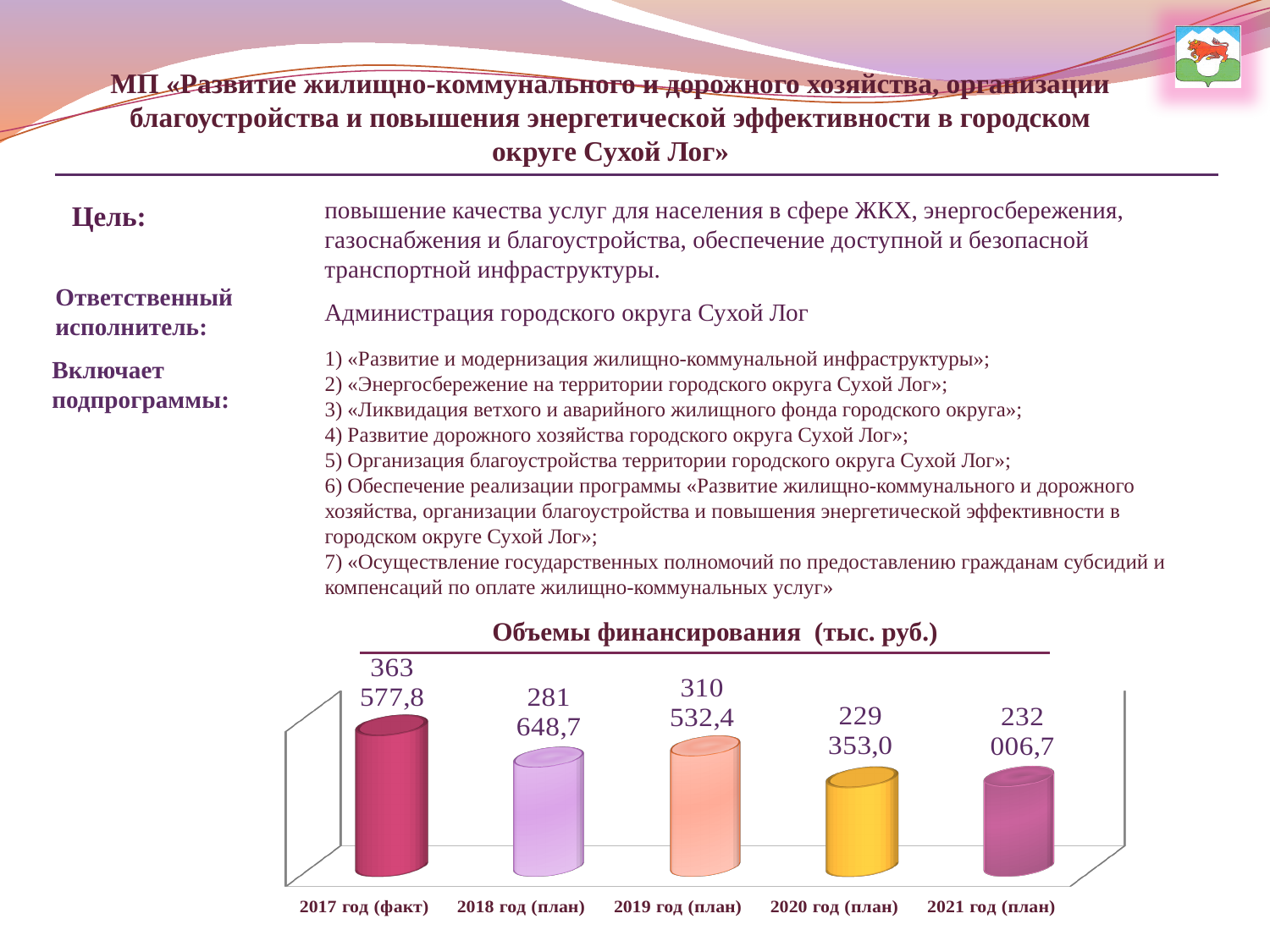
What is the difference between the values for 2017 год (факт) and 2018 год (план)? 81 929,1 What is the value for 2021 год (план) in the chart? 232 006,7 Does the value rise or fall from 2017 год (факт) to 2018 год (план)? fall Which category has the lowest value in the chart? 2020 год (план) What is the value for 2019 год (план) in the chart? 310 532,4 How many categories are shown in the chart? 5 What is the value for 2017 год (факт) in the chart? 363 577,8 What kind of chart is shown on the slide? bar chart Which category has the highest value in the chart? 2017 год (факт) Which is larger, the value for 2018 год (план) or 2019 год (план)? 2019 год (план) What is the difference between the values for 2021 год (план) and 2020 год (план)? 2 653,7 What is the title of the chart? Объемы финансирования (тыс. руб.)